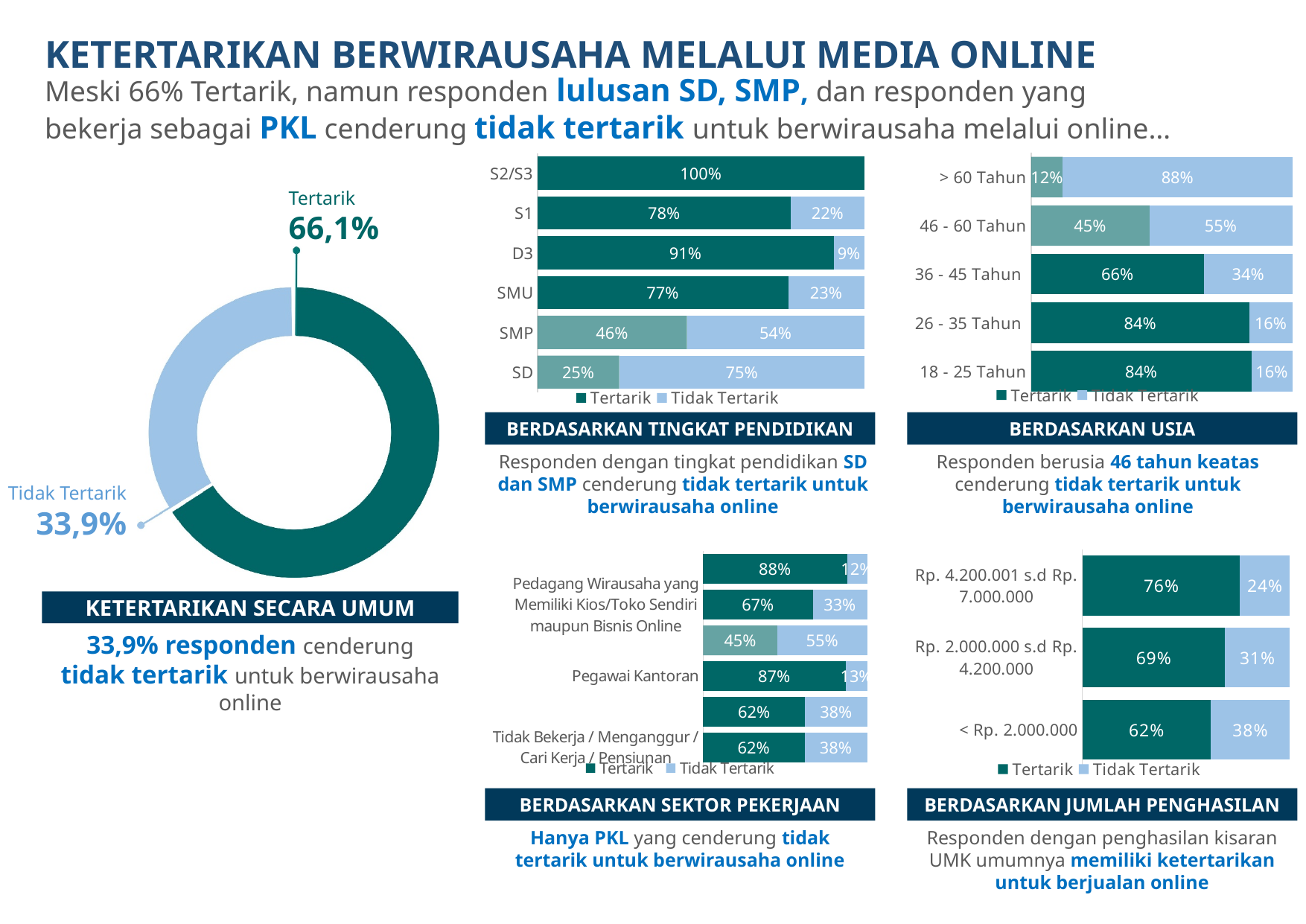
In the Berdasarkan Tingkat Pendidikan chart, what is the Tertarik value for D3? 91% In the Berdasarkan Jumlah Penghasilan chart, what is the difference between the Tertarik value for Rp. 4.200.001 s.d Rp. 7.000.000 and the Tertarik value for < Rp. 2.000.000? 14% How many series does the legend of the Berdasarkan Usia chart list? 2 In the Berdasarkan Tingkat Pendidikan chart, what is the Tidak Tertarik value for SD? 75% How many education levels are shown in the Berdasarkan Tingkat Pendidikan chart? 6 In the Berdasarkan Tingkat Pendidikan chart, which education level has the highest Tertarik value? S2/S3 In the Berdasarkan Usia chart, what is the Tertarik value for 36 - 45 Tahun? 66% In the Berdasarkan Usia chart, what is the Tidak Tertarik value for > 60 Tahun? 88% In the Berdasarkan Usia chart, which age group has the lowest Tertarik value? > 60 Tahun What kind of chart is the Ketertarikan Secara Umum chart? donut chart In the Berdasarkan Jumlah Penghasilan chart, what is the Tertarik value for Rp. 4.200.001 s.d Rp. 7.000.000? 76% In the Ketertarikan Secara Umum chart, what percentage of respondents are Tertarik? 66,1%